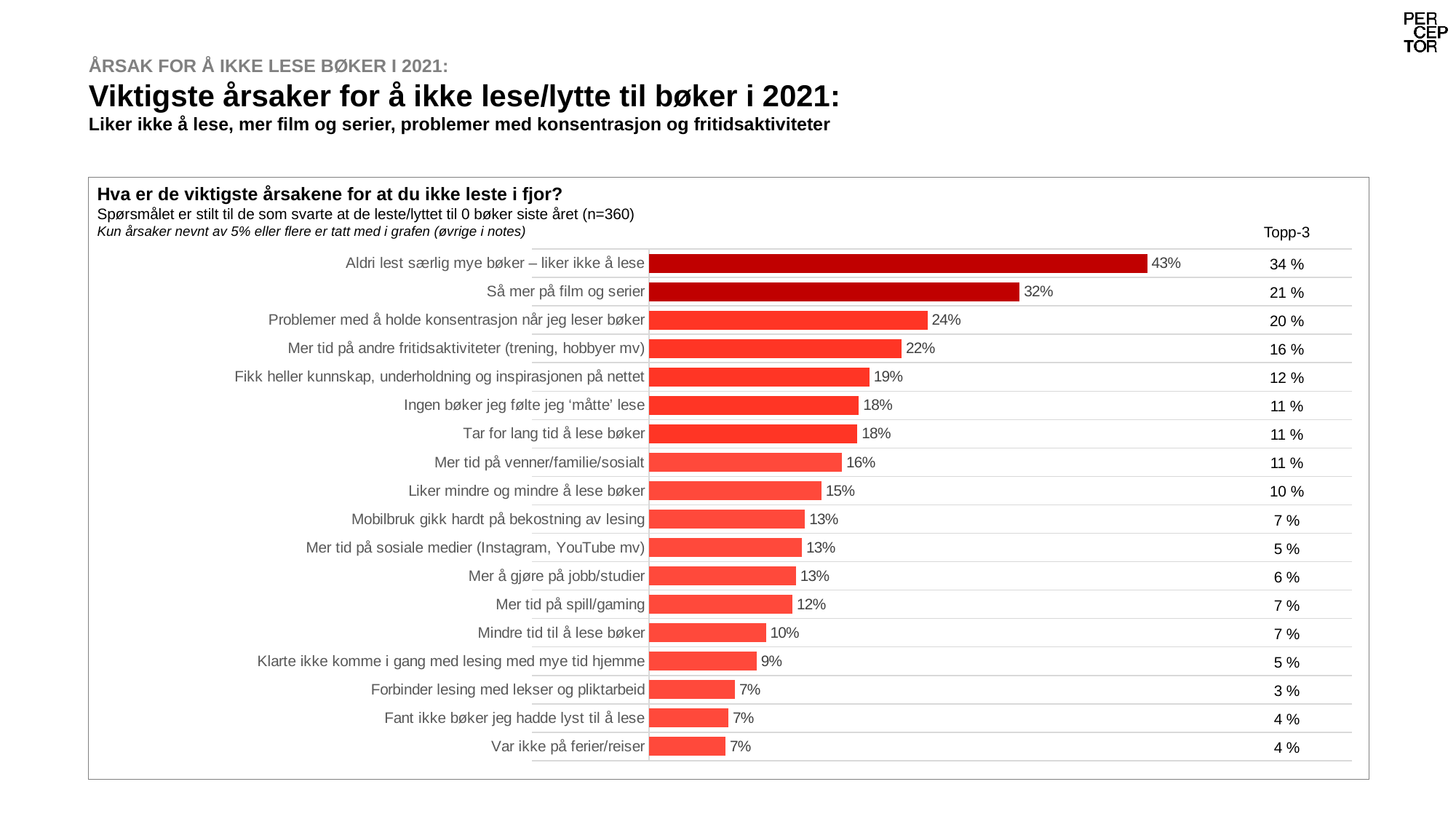
What value is shown for "Problemer med å holde konsentrasjon når jeg leser bøker"? 24% What is the sample size (n) stated above the chart? n=360 How many reasons (categories) are plotted in the chart? 18 What type of chart is shown on the slide? Bar chart What is the difference in percentage points between "Fikk heller kunnskap, underholdning og inspirasjonen på nettet" and "Mindre tid til å lese bøker"? 9 What percentage is shown for "Så mer på film og serier"? 32% Which reason has the highest percentage in the chart? Aldri lest særlig mye bøker – liker ikke å lese Which has a higher value: "Liker mindre og mindre å lese bøker" or "Forbinder lesing med lekser og pliktarbeid"? Liker mindre og mindre å lese bøker Which has a higher value: "Mer tid på andre fritidsaktiviteter (trening, hobbyer mv)" or "Mer tid på venner/familie/sosialt"? Mer tid på andre fritidsaktiviteter (trening, hobbyer mv) What is the difference in percentage points between "Aldri lest særlig mye bøker – liker ikke å lese" and "Så mer på film og serier"? 11 What value is shown for "Klarte ikke komme i gang med lesing med mye tid hjemme"? 9% What percentage is shown for "Mer tid på spill/gaming"? 12%